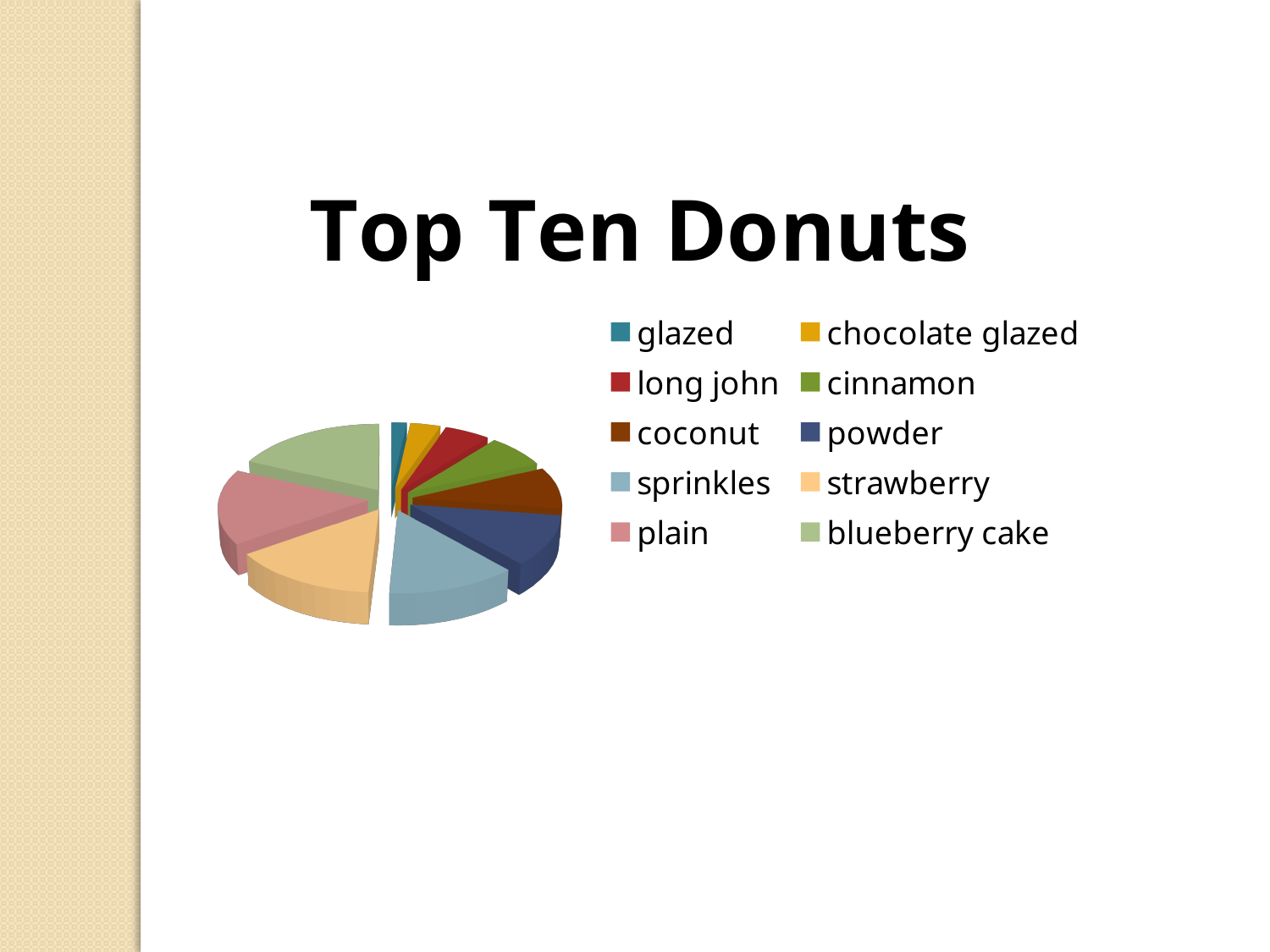
Which slice is larger, glazed or coconut? coconut What kind of chart is shown on the slide? pie chart Which donut category has the smallest slice of the pie? glazed Which slice is larger, chocolate glazed or sprinkles? sprinkles Which donut category is shown in the legend with a dark blue colour? powder Which slice is larger, glazed or blueberry cake? blueberry cake How many entries does the legend list? 10 What is the title of the chart? Top Ten Donuts How many donut categories does the pie chart show? 10